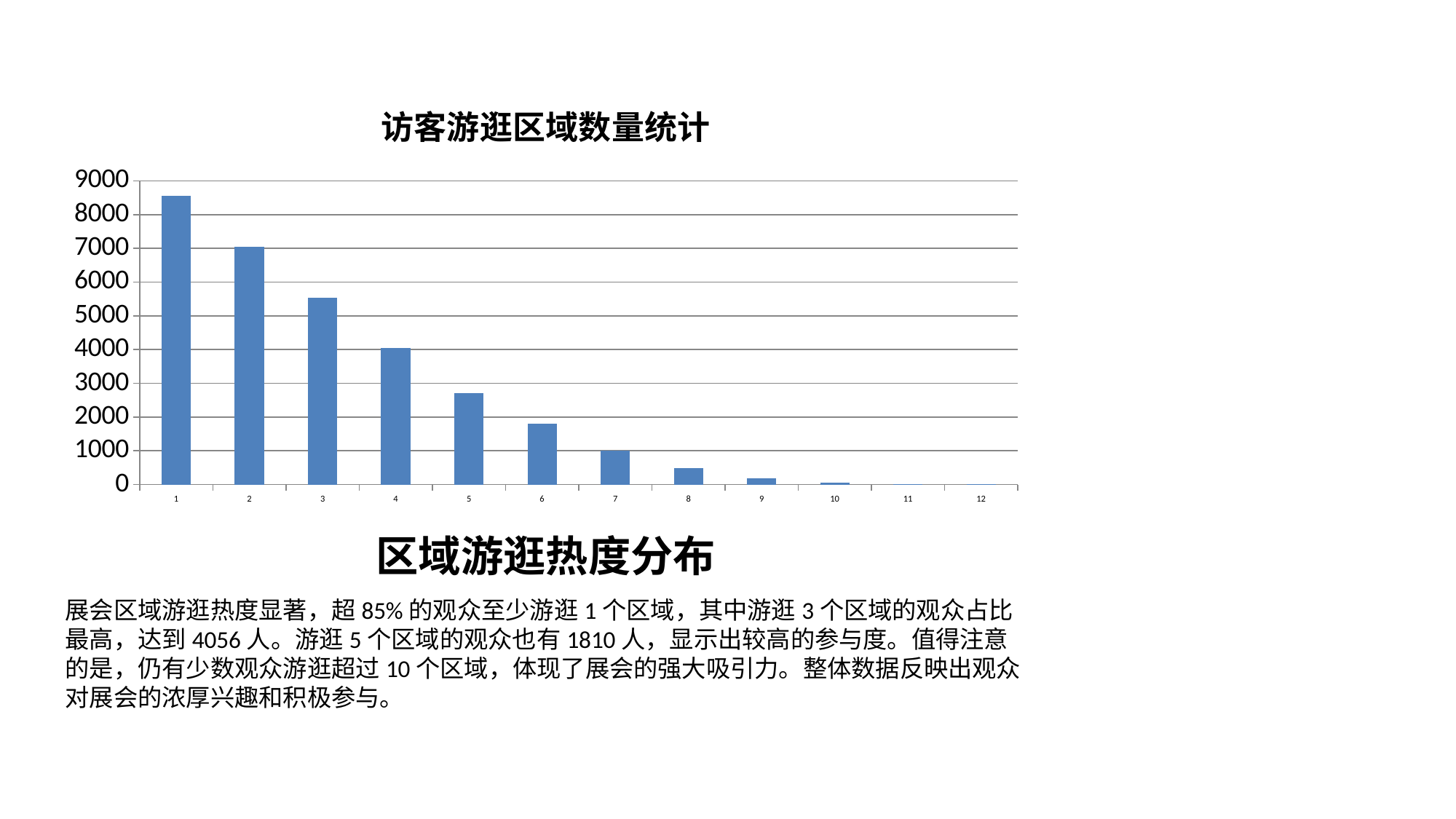
Is the value for category 3 greater or less than 5000? greater Is the value for category 6 greater or less than 2000? less How many categories are shown on the x axis of the chart? 12 Which has a larger value, category 4 or category 7? 4 What is the title of the chart? 访客游逛区域数量统计 Is the value for category 5 greater or less than 3000? less What kind of chart is shown on the slide? bar chart Do the values rise or fall as the category number increases from 1 to 12? fall Which category has the highest value in the chart? 1